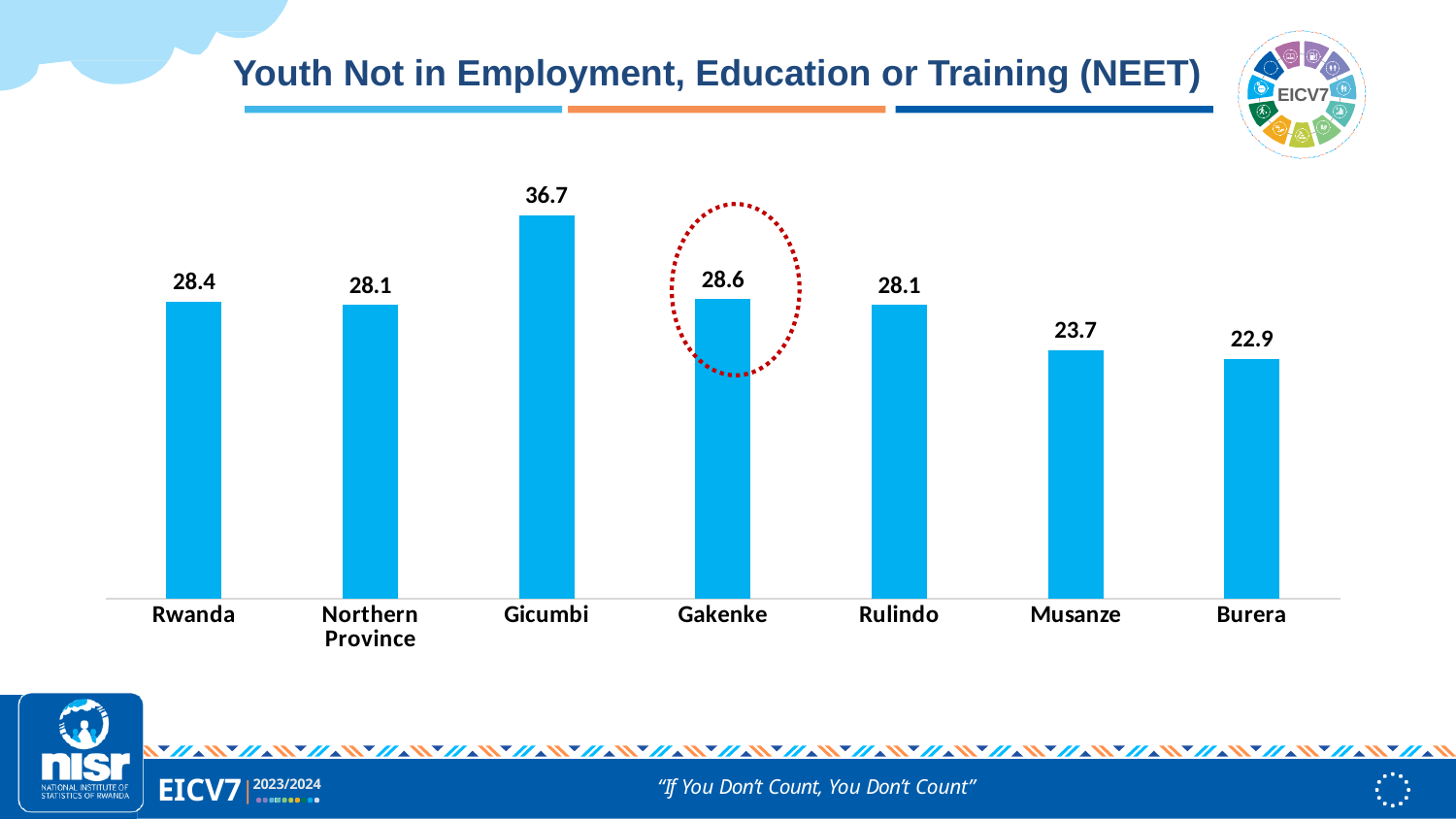
What is the difference between the values for Gicumbi and Musanze? 13.0 How many categories are shown on the chart? 7 Which is larger, the value for Musanze or the value for Rulindo? Rulindo Which category has the highest value? Gicumbi What kind of chart is shown on the slide? Bar chart What is the difference between the values for Gakenke and Burera? 5.7 What is the value for Gicumbi? 36.7 Which category has the lowest value? Burera What is the value for Rwanda? 28.4 What is the value for Burera? 22.9 What is the value for Gakenke? 28.6 What is the title of the chart? Youth Not in Employment, Education or Training (NEET)